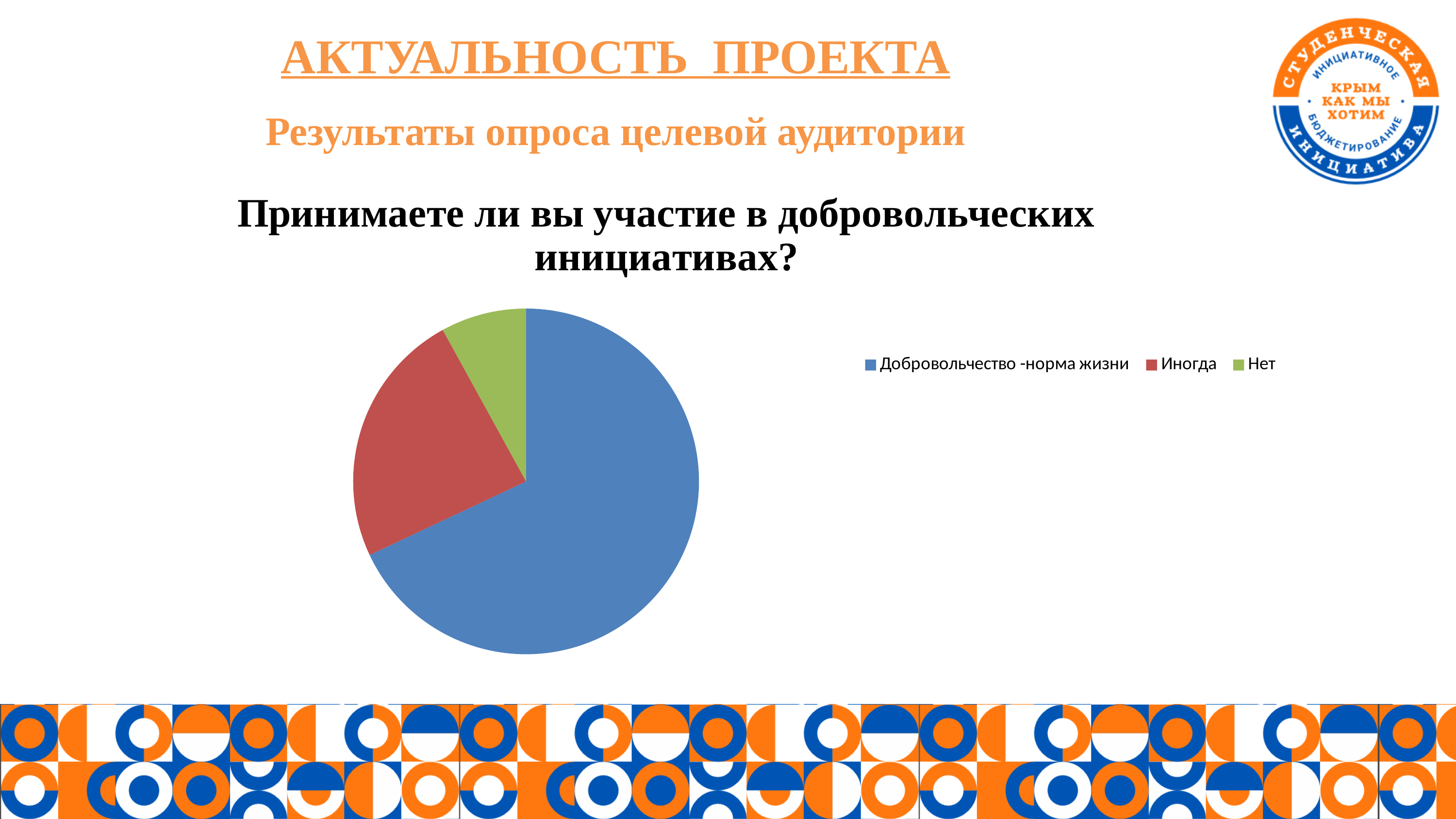
Which slice is larger: Иногда or Нет? Иногда How many slices does the pie chart have? 3 Which category has the largest slice of the pie chart? Добровольчество -норма жизни Which category has the smallest slice of the pie chart? Нет How many entries does the legend of the pie chart list? 3 What is the title of the pie chart? Принимаете ли вы участие в добровольческих инициативах? What colour is the slice for Иногда in the pie chart? red Which slice is larger: Добровольчество -норма жизни or Иногда? Добровольчество -норма жизни What kind of chart is shown on the slide? pie chart